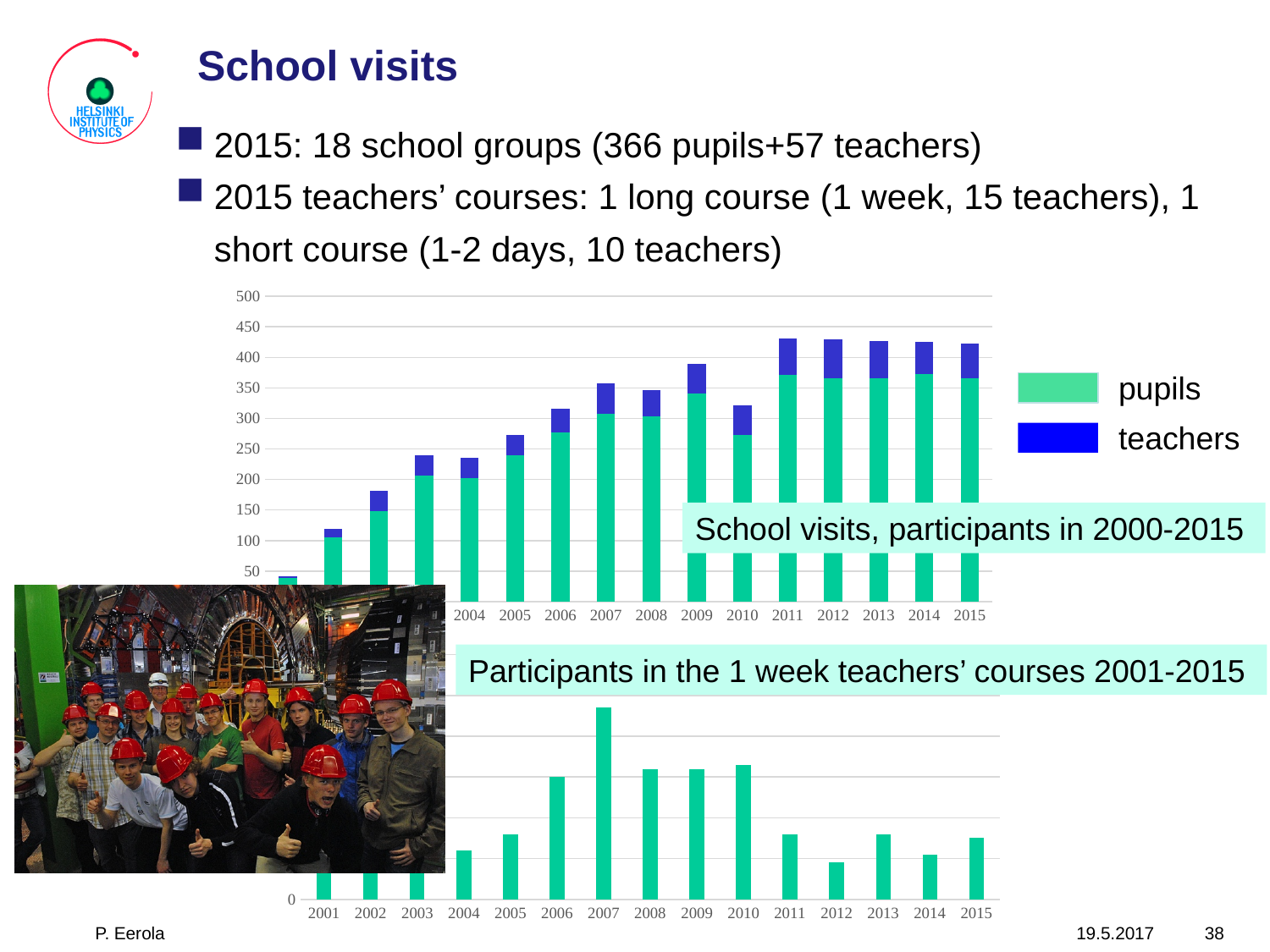
In the 'Participants in the 1 week teachers' courses 2001-2015' chart, which year has the larger value, 2007 or 2012? 2007 How many series does the legend of the 'School visits, participants in 2000-2015' chart list? 2 What kind of chart is the 'School visits, participants in 2000-2015' chart? stacked bar chart In the 'School visits, participants in 2000-2015' chart, which series is shown in blue? teachers In the 'School visits, participants in 2000-2015' chart, which year has more pupils, 2009 or 2010? 2009 What kind of chart is the 'Participants in the 1 week teachers' courses 2001-2015' chart? bar chart In the 'School visits, participants in 2000-2015' chart, is the total for 2007 greater or less than 300? greater In the 'School visits, participants in 2000-2015' chart, is the total for 2010 greater or less than 350? less How many years are shown on the x axis of the 'Participants in the 1 week teachers' courses 2001-2015' chart? 15 In the 'School visits, participants in 2000-2015' chart, is the total for 2015 greater or less than 400? greater In the 'School visits, participants in 2000-2015' chart, do the totals generally rise or fall from 2004 to 2009? rise